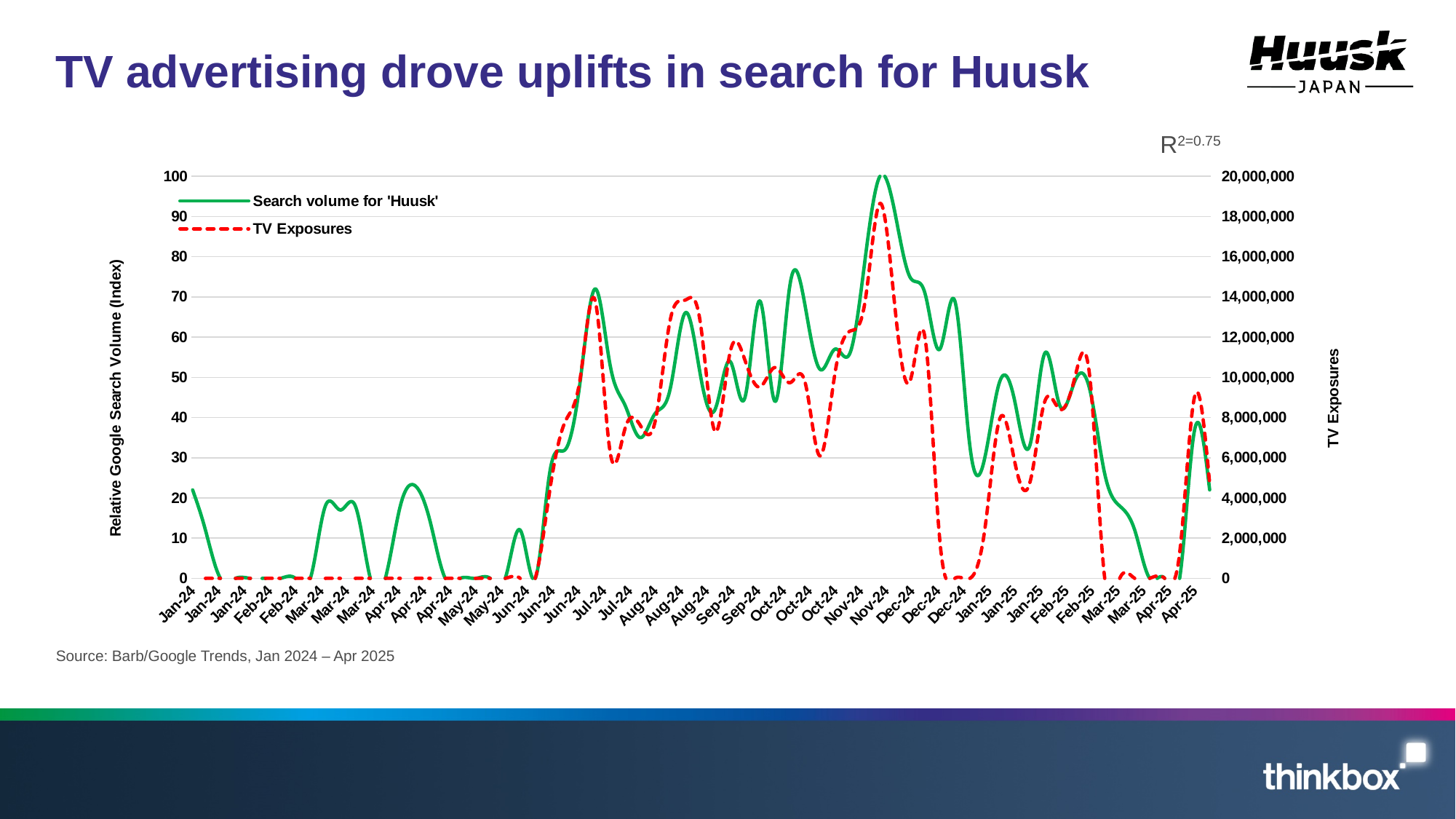
Does the search volume for 'Huusk' generally rise or fall between Nov-24 and Mar-25? fall Are TV Exposures in Feb-24 greater or less than 2,000,000? less Is the search volume for 'Huusk' at the final Apr-25 point greater or less than 30? less In which month does the search volume for 'Huusk' reach its highest point? Nov-24 Does the search volume for 'Huusk' generally rise or fall between Jun-24 and Nov-24? rise What is the title of the slide? TV advertising drove uplifts in search for Huusk Is the search volume for 'Huusk' at its Jul-24 peak greater or less than 60? greater How many series does the chart's legend list? 2 What is the peak value of the search volume for 'Huusk' index, reached in Nov-24? 100 What R-squared value is shown on the chart? R2=0.75 What kind of chart is shown on the slide? Line chart